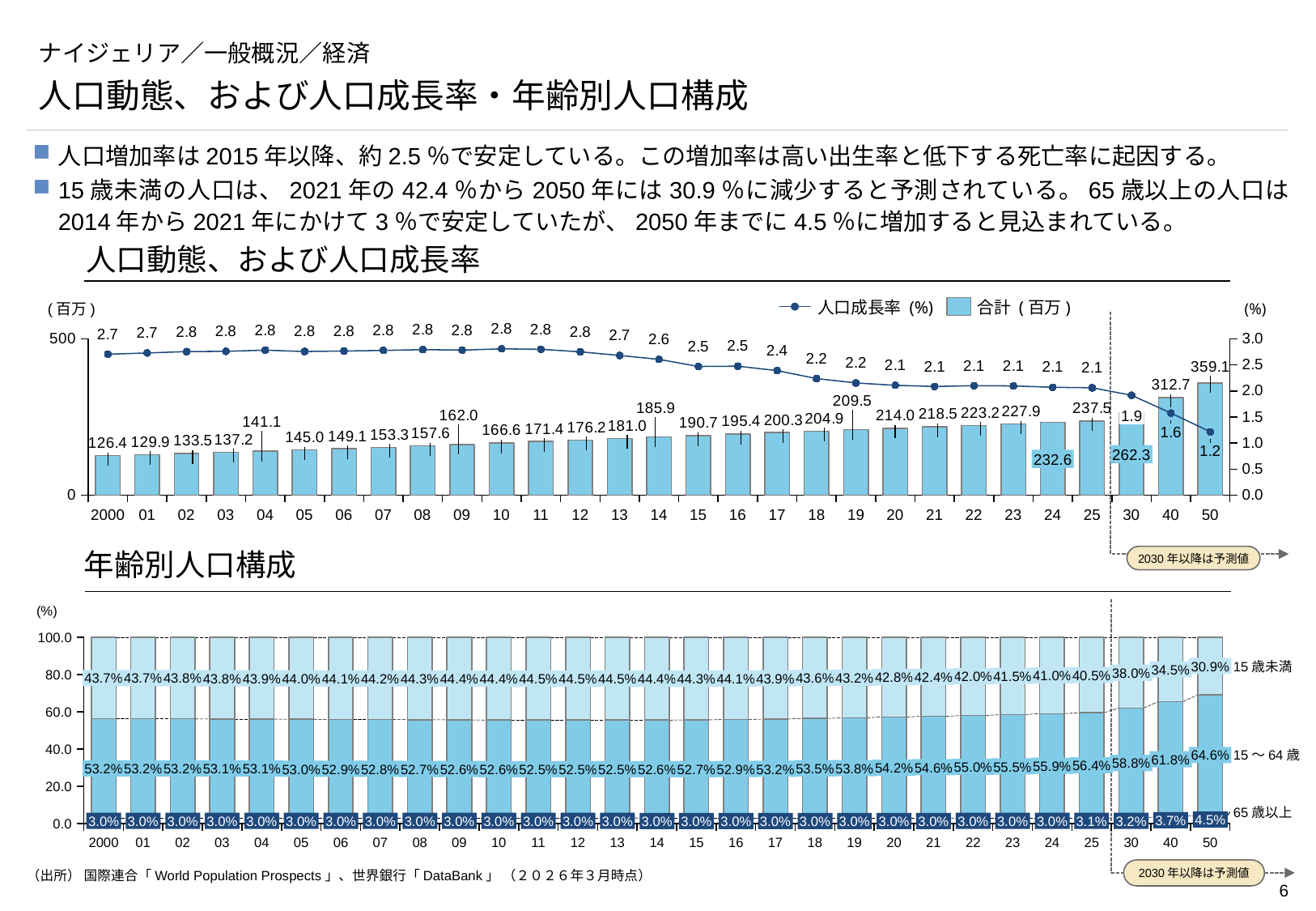
In the top chart 人口動態、および人口成長率, does the population growth rate line rise or fall from 2015 to 2050? fall In the top chart 人口動態、および人口成長率, which year has the lowest population growth rate? 2050 In the top chart 人口動態、および人口成長率, what is the total population (百万) for 2000? 126.4 In the top chart 人口動態、および人口成長率, which year has the highest total population? 2050 In the top chart 人口動態、および人口成長率, what is the total population (百万) for 2050? 359.1 In the top chart 人口動態、および人口成長率, what is the difference in total population (百万) between 2050 and 2000? 232.7 In the bottom chart 年齢別人口構成, which is larger in 2050: the share of 15歳未満 or the share of 15～64歳? 15～64歳 In the bottom chart 年齢別人口構成, what is the share of 65歳以上 in 2050? 4.5% In the top chart 人口動態、および人口成長率, what is the population growth rate (%) for 2040? 1.6 What kind of chart is the bottom chart 年齢別人口構成? stacked bar chart In the top chart 人口動態、および人口成長率, how many series does the legend list? 2 In the bottom chart 年齢別人口構成, what is the share of 15歳未満 in 2021? 42.4%